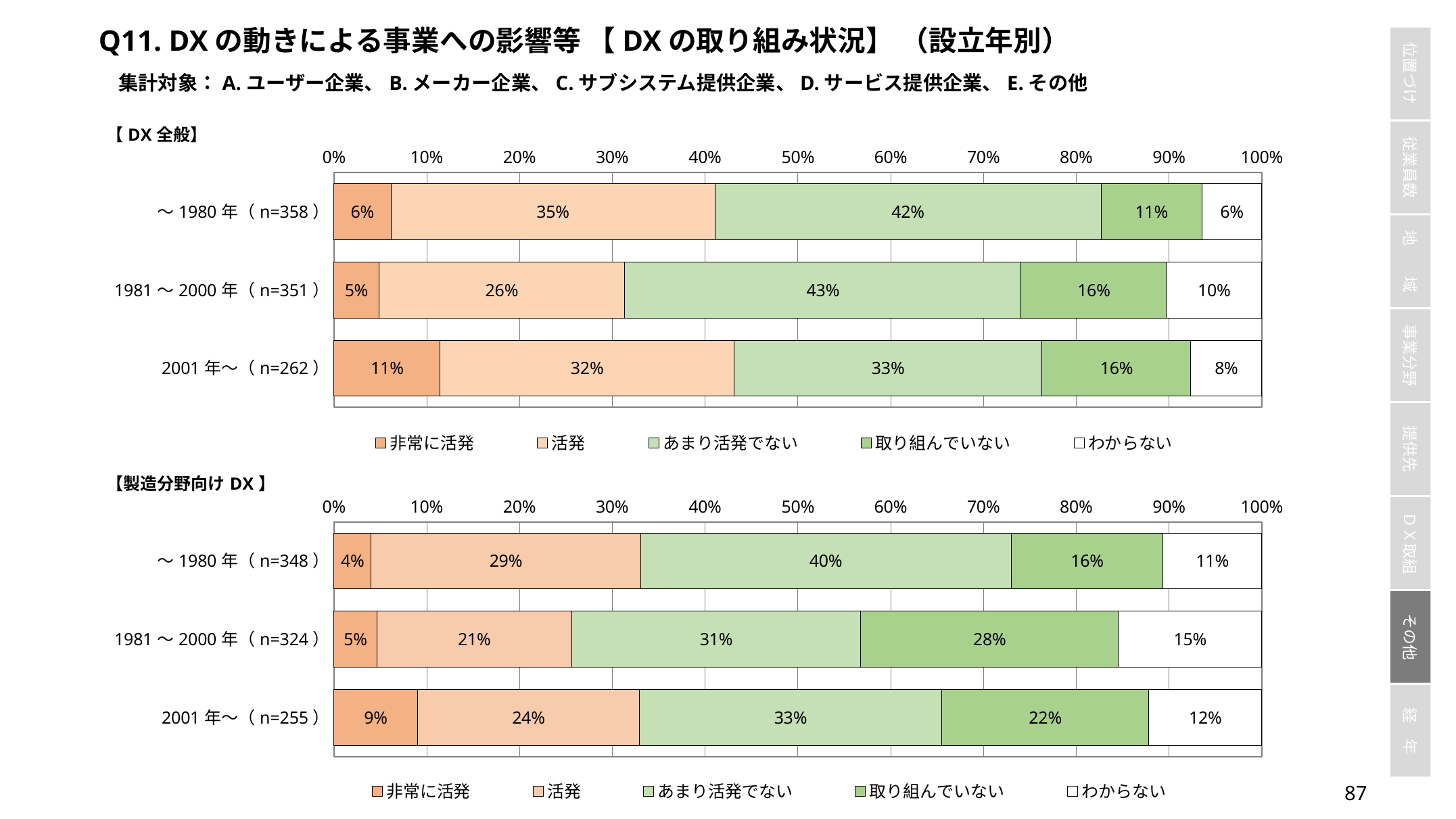
In the 【DX全般】 chart, what is the difference between the 「あまり活発でない」 values for 1981～2000年 and 2001年～? 10% In the 【製造分野向け DX】 chart, how many categories are shown on the vertical axis? 3 In the 【製造分野向け DX】 chart, which category has the lowest value for 「活発」? 1981～2000年 (n=324) In the 【製造分野向け DX】 chart, which is larger: the 「あまり活発でない」 value for ～1980年 or for 2001年～? ～1980年 In the 【製造分野向け DX】 chart, what is the value for 「わからない」 for 2001年～ (n=255)? 12% In the 【DX全般】 chart, what is the combined value of 「非常に活発」 and 「活発」 for 2001年～ (n=262)? 43% In the 【DX全般】 chart, what is the value for 「取り組んでいない」 for 1981～2000年 (n=351)? 16% In the 【DX全般】 chart, how many series does the legend list? 5 In the 【製造分野向け DX】 chart, what is the value for 「取り組んでいない」 for 1981～2000年 (n=324)? 28% In the 【DX全般】 chart, which category has the highest value for 「非常に活発」? 2001年～ (n=262) What kind of chart is the 【製造分野向け DX】 chart? Stacked horizontal bar chart In the 【DX全般】 chart, what is the value for 「活発」 for ～1980年 (n=358)? 35%